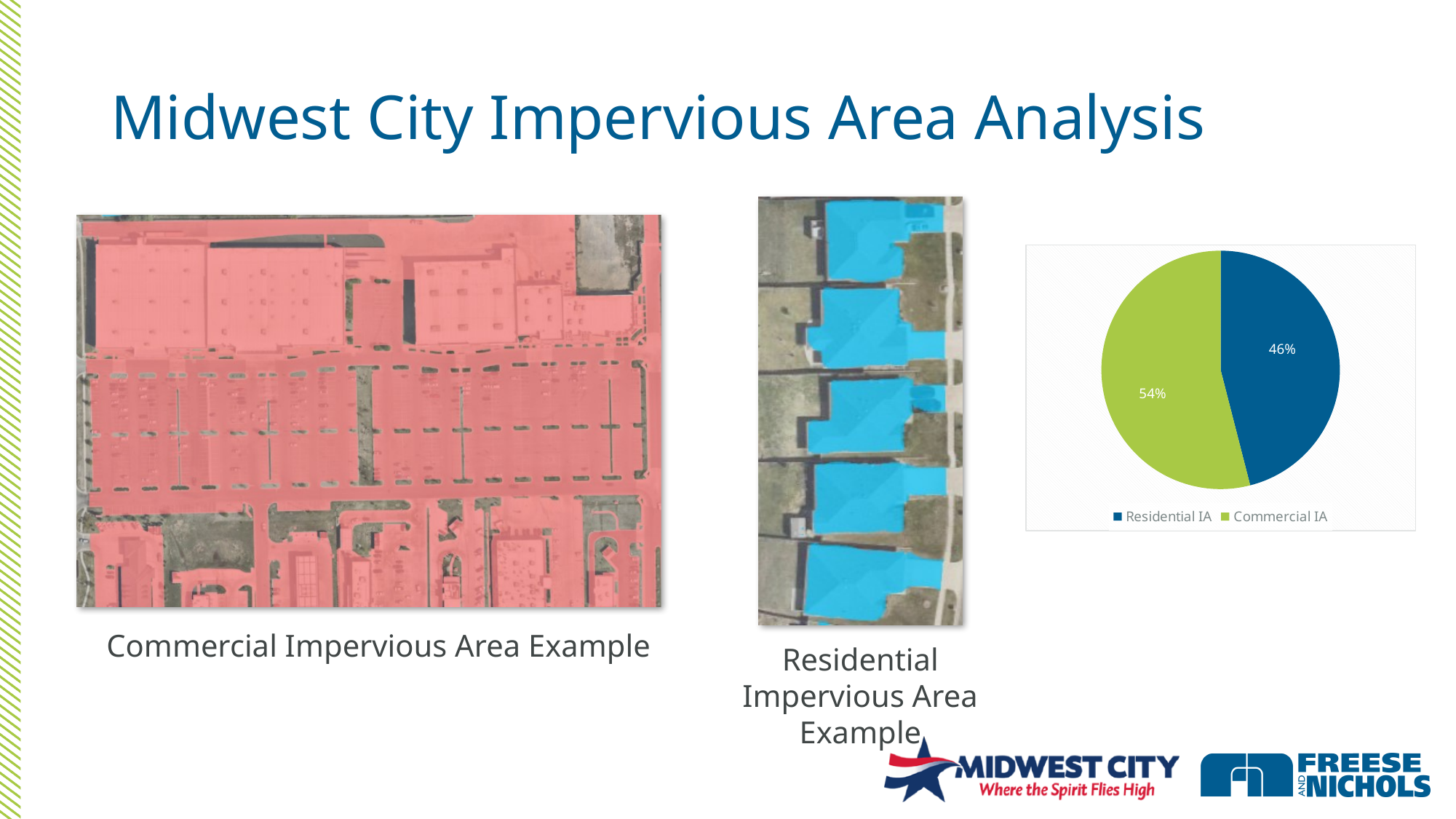
Which is larger in the pie chart, Residential IA or Commercial IA? Commercial IA What is the difference in percentage points between the Commercial IA and Residential IA slices? 8 Which slice of the pie chart is the largest? Commercial IA What share of the pie chart is Commercial IA? 54% What colour is the Commercial IA slice in the pie chart? green What colour is the Residential IA slice in the pie chart? blue What share of the pie chart is Residential IA? 46% How many slices does the pie chart have? 2 What kind of chart is shown on the slide? pie chart Is the Residential IA share of the pie chart greater or less than 50%? less Which slice of the pie chart is the smallest? Residential IA How many entries does the pie chart legend list? 2